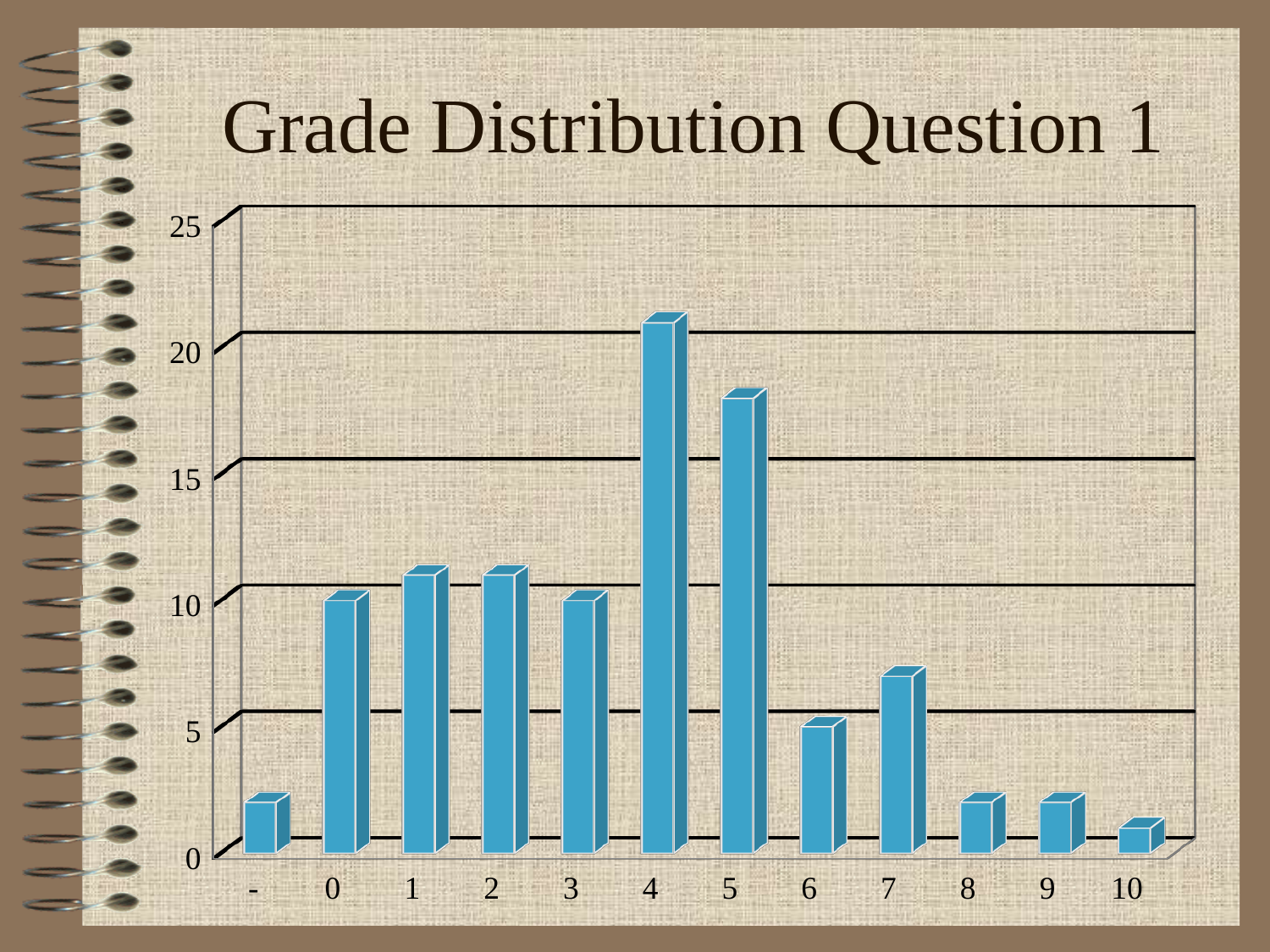
What kind of chart is shown on the slide? bar chart Is the value for category 5 greater or less than 20? less Which is larger, the value for category 1 or the value for category 8? 1 Is the value for category 7 greater or less than 5? greater Which is larger, the value for category 4 or the value for category 5? 4 Is the value for category 4 greater or less than 20? greater How many categories are shown along the x axis? 12 What is the value for category 6? 5 Which category has the highest bar? 4 Which category has the lowest bar? 10 What is the title of the chart? Grade Distribution Question 1